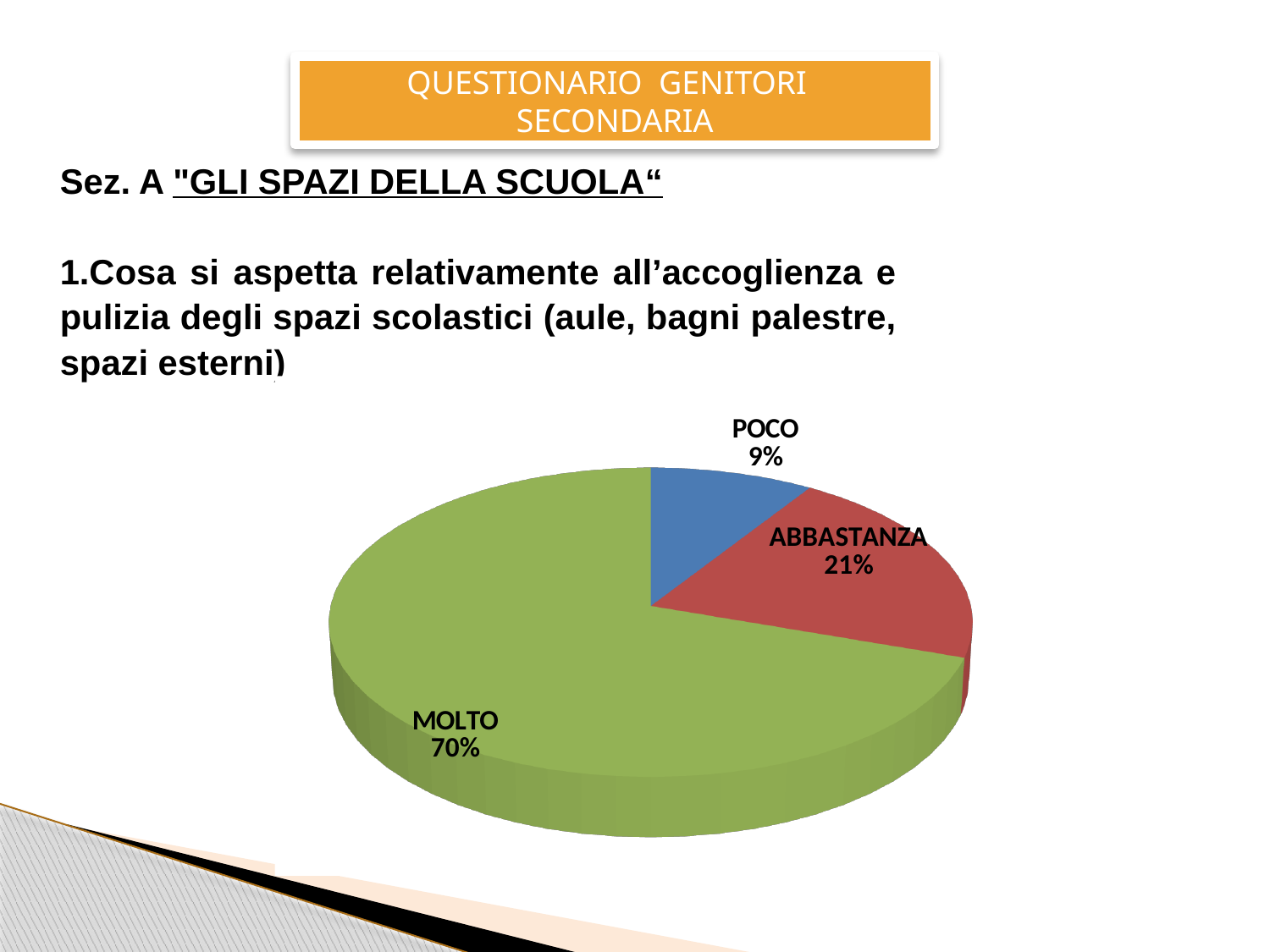
What colour is the MOLTO slice of the pie chart? Green Which slice is larger, ABBASTANZA or POCO? ABBASTANZA What percentage of the pie chart is labelled POCO? 9% What kind of chart is shown on the slide? Pie chart What is the difference in percentage points between the MOLTO and ABBASTANZA slices? 49 Which category has the smallest slice of the pie chart? POCO What colour is the POCO slice of the pie chart? Blue How many slices does the pie chart have? 3 Which category has the largest slice of the pie chart? MOLTO What is the difference in percentage points between the ABBASTANZA and POCO slices? 12 What percentage of the pie chart is labelled ABBASTANZA? 21% What percentage of the pie chart is labelled MOLTO? 70%